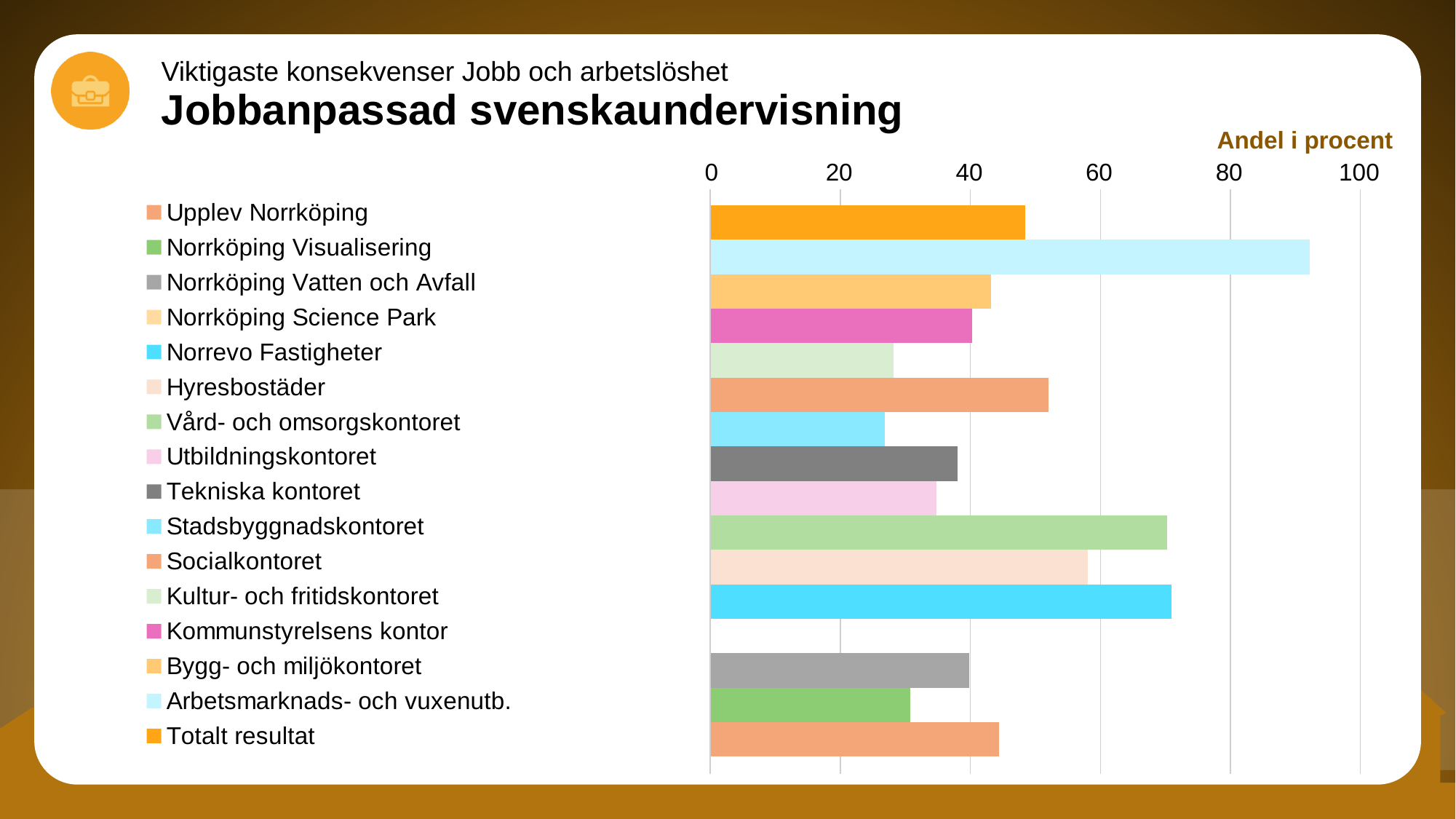
Is the value for Kultur- och fritidskontoret greater or less than 40? less Which category has the highest value in the chart? Arbetsmarknads- och vuxenutb. Is the value for Norrevo Fastigheter greater or less than 60? greater Is the value for Totalt resultat greater or less than 60? less What kind of chart is shown on the slide? bar chart Which is larger, the value for Socialkontoret or the value for Kultur- och fritidskontoret? Socialkontoret What is the label shown above the horizontal axis of the chart? Andel i procent How many entries does the legend list? 16 Which is larger, the value for Arbetsmarknads- och vuxenutb. or the value for Totalt resultat? Arbetsmarknads- och vuxenutb.